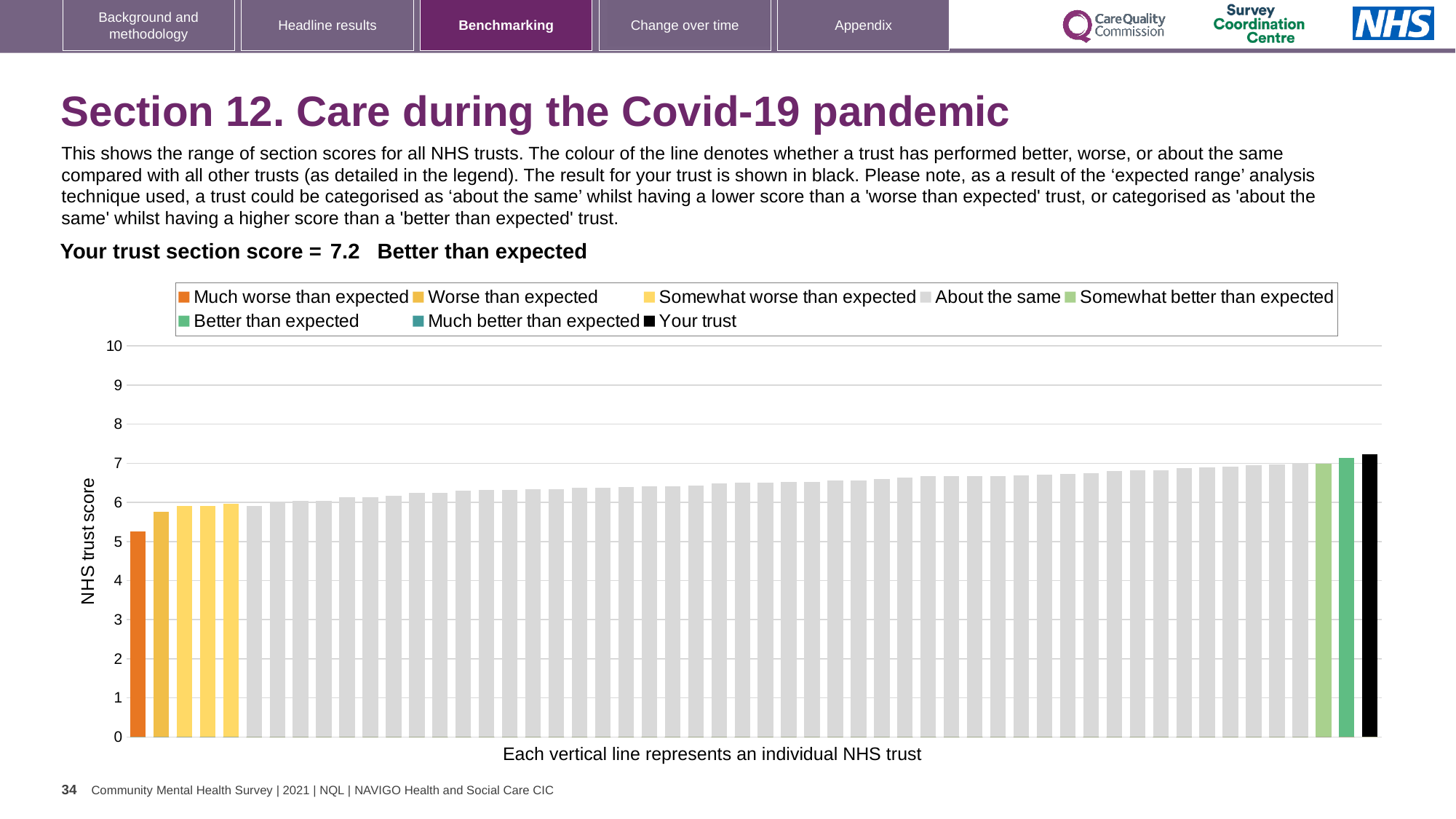
Is the value of the lowest bar on the chart greater or less than 6? less How many entries does the chart legend list? 8 Which is larger, the value for Your trust or the value of the 'Much worse than expected' bar? Your trust Which bar has the highest NHS trust score on the chart? Your trust Do the bar values rise or fall moving from left to right along the x axis? rise What is the section score for your trust shown on the slide? 7.2 Is the value for Your trust greater or less than 7? greater Is the value of the lowest bar on the chart greater or less than 5? greater How many bars on the chart are coloured orange for 'Much worse than expected'? 1 What is the label on the vertical axis of the chart? NHS trust score What kind of chart is shown on the slide? bar chart Which category does the lowest bar on the chart belong to? Much worse than expected